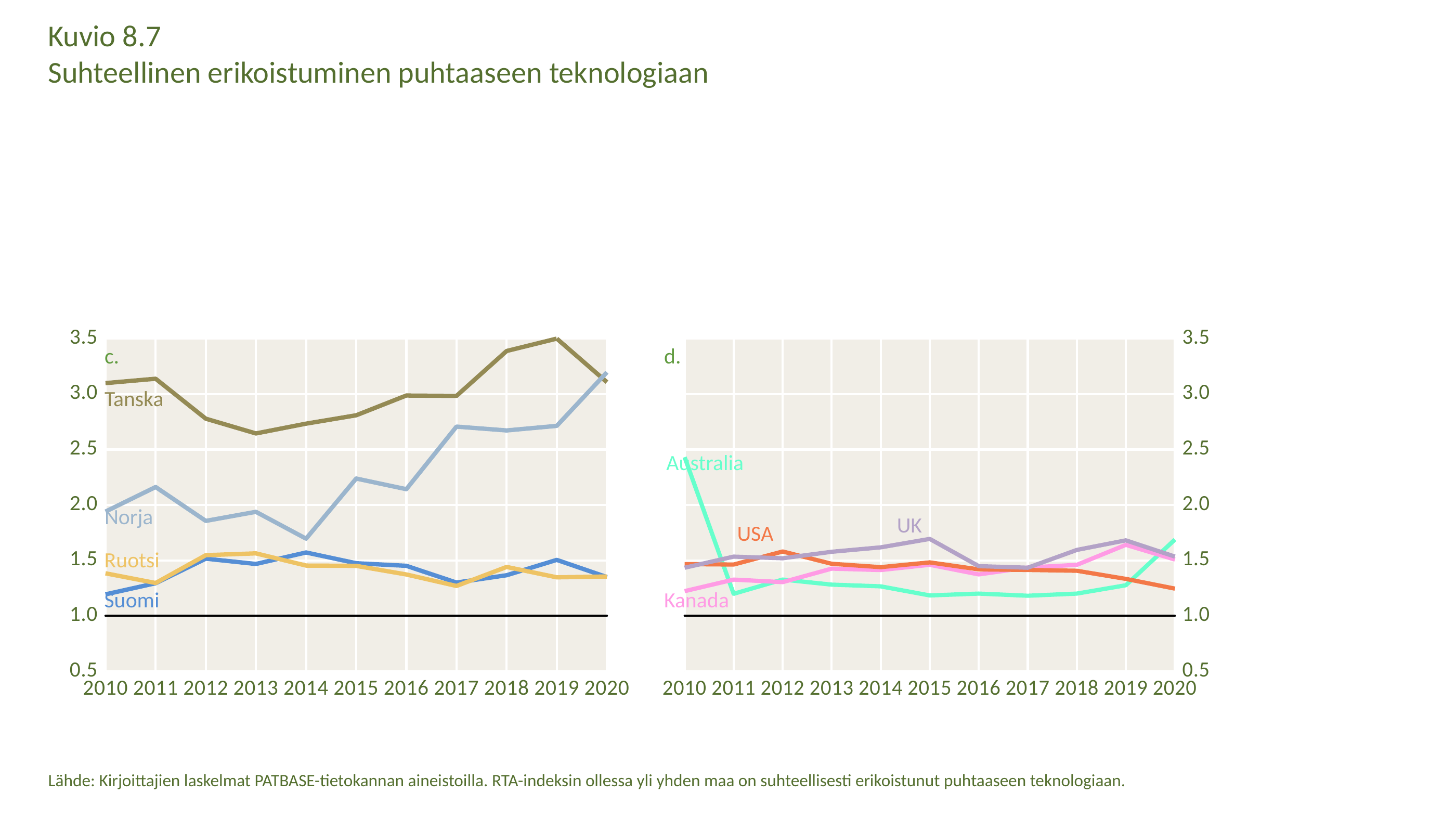
In the left chart (c.), which is larger in 2015, Tanska or Norja? Tanska How many years are shown on the x axis of the left chart (c.)? 11 In the left chart (c.), is the value for Tanska in 2010 greater or less than 3.0? greater How many countries are plotted in the left chart (c.)? 4 In the left chart (c.), is the value for Norja in 2014 greater or less than 2.0? less In the right chart (d.), is the value for Australia in 2015 greater or less than 1.5? less In the right chart (d.), which country has the highest value in 2010? Australia In the right chart (d.), does the USA line rise or fall from 2015 to 2020? fall In the left chart (c.), which country has the lowest value in 2010? Suomi How many countries are plotted in the right chart (d.)? 4 In the left chart (c.), which country has the highest value in 2019? Tanska What kind of chart is the left chart (c.)? line chart